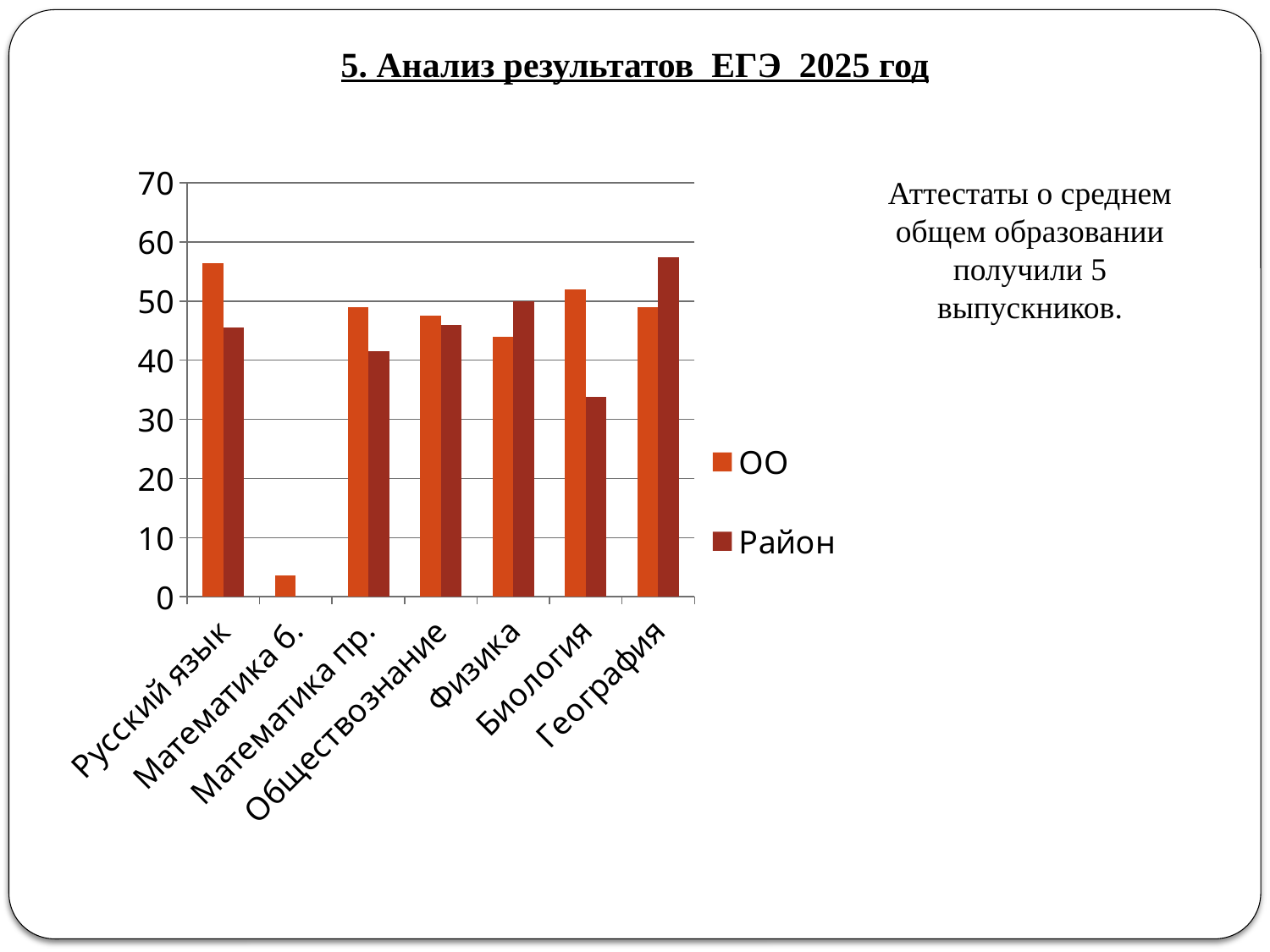
What kind of chart is shown on the slide? bar chart How many subject categories are shown on the x axis? 7 For География, which series has the larger value, ОО or Район? Район Is the ОО value for Русский язык greater or less than 50? greater Is the Район value for Биология greater or less than 40? less What are the two series names listed in the legend? ОО and Район Which category has the highest value for the Район series? География Which category has the highest value for the ОО series? Русский язык For Биология, which series has the larger value, ОО or Район? ОО Which category has the lowest value for the ОО series? Математика б. Is the ОО value for Математика б. greater or less than 10? less How many series does the legend list? 2